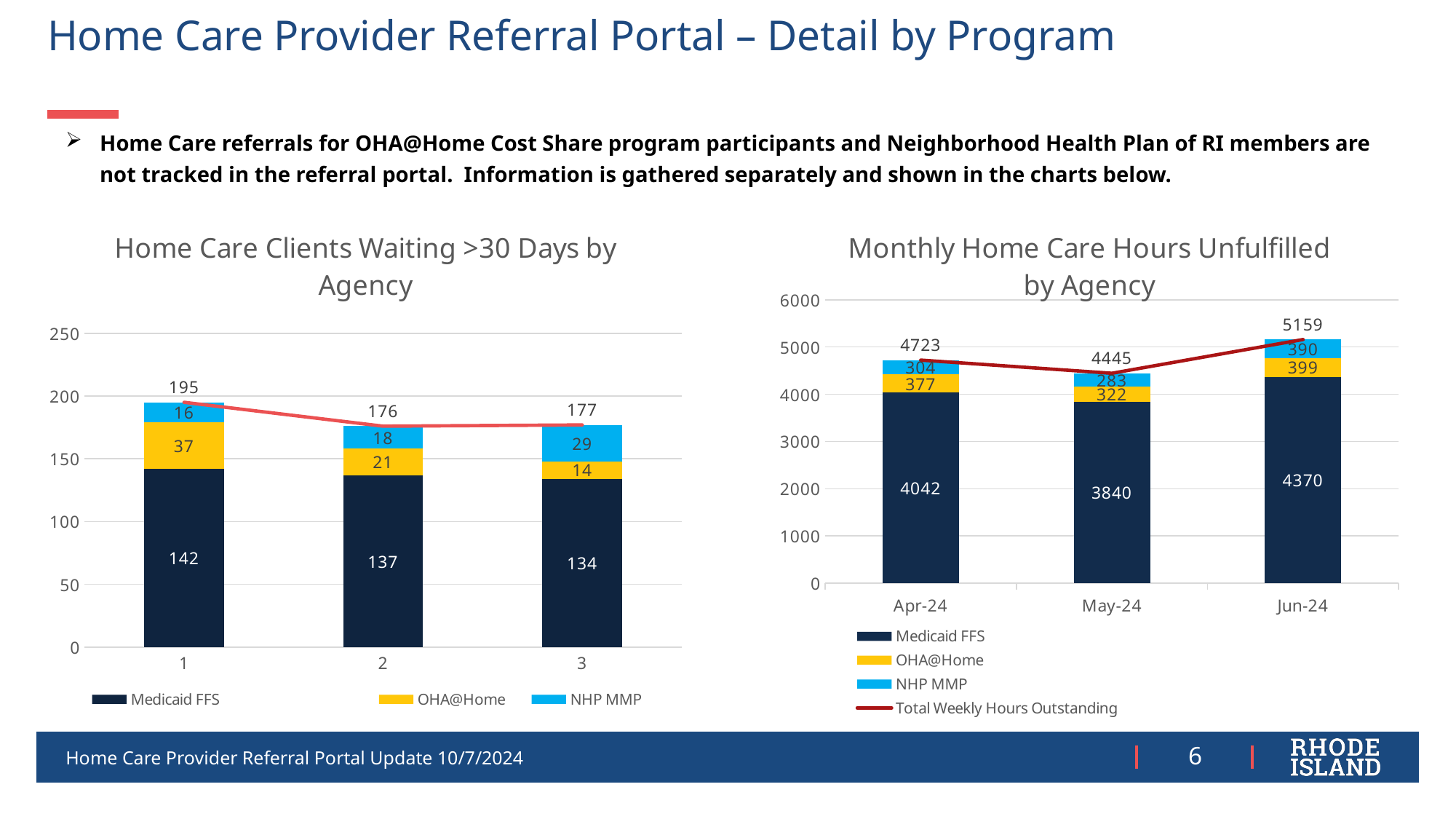
In the 'Monthly Home Care Hours Unfulfilled by Agency' chart, what is the Medicaid FFS value for May-24? 3840 In the 'Home Care Clients Waiting >30 Days by Agency' chart, which category has the lowest Medicaid FFS value? 3 In the 'Home Care Clients Waiting >30 Days by Agency' chart, is the OHA@Home value larger for category 1 or category 3? category 1 In the 'Home Care Clients Waiting >30 Days by Agency' chart, what is the total of the stacked bar for category 2? 176 In the 'Monthly Home Care Hours Unfulfilled by Agency' chart, what is the difference between the Medicaid FFS values for Jun-24 and May-24? 530 In the 'Home Care Clients Waiting >30 Days by Agency' chart, what is the NHP MMP value for category 3? 29 In the 'Monthly Home Care Hours Unfulfilled by Agency' chart, which month has the highest total? Jun-24 What kind of chart is the 'Home Care Clients Waiting >30 Days by Agency' chart? stacked bar chart with a line (combination bar and line chart) In the 'Monthly Home Care Hours Unfulfilled by Agency' chart, what is the OHA@Home value for Jun-24? 399 How many entries does the legend of the 'Monthly Home Care Hours Unfulfilled by Agency' chart list? 4 In the 'Home Care Clients Waiting >30 Days by Agency' chart, what is the OHA@Home value for category 1? 37 How many months are shown on the x axis of the 'Monthly Home Care Hours Unfulfilled by Agency' chart? 3